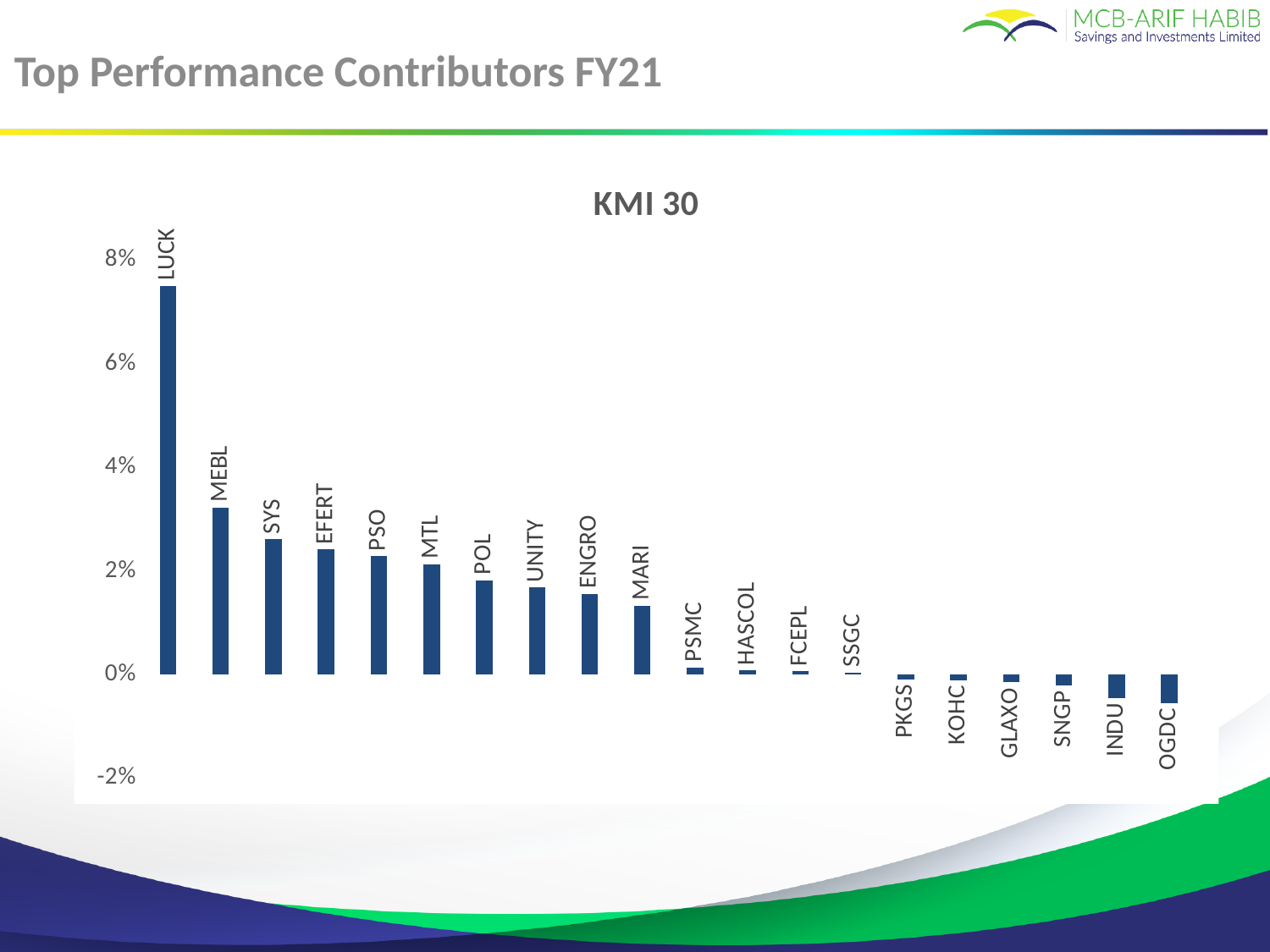
Is the value for MARI greater or less than 2%? less Which has a larger value, POL or MARI? POL Is the value for LUCK greater or less than 6%? greater What kind of chart is shown on the slide? Bar chart How many categories are plotted in the chart? 20 Is the value for MEBL greater or less than 4%? less What is the title of the chart? KMI 30 Which category has the highest value in the chart? LUCK Which has a larger value, MEBL or SYS? MEBL Do the values generally rise or fall moving from left to right along the x axis? Fall Which category has the lowest value in the chart? OGDC